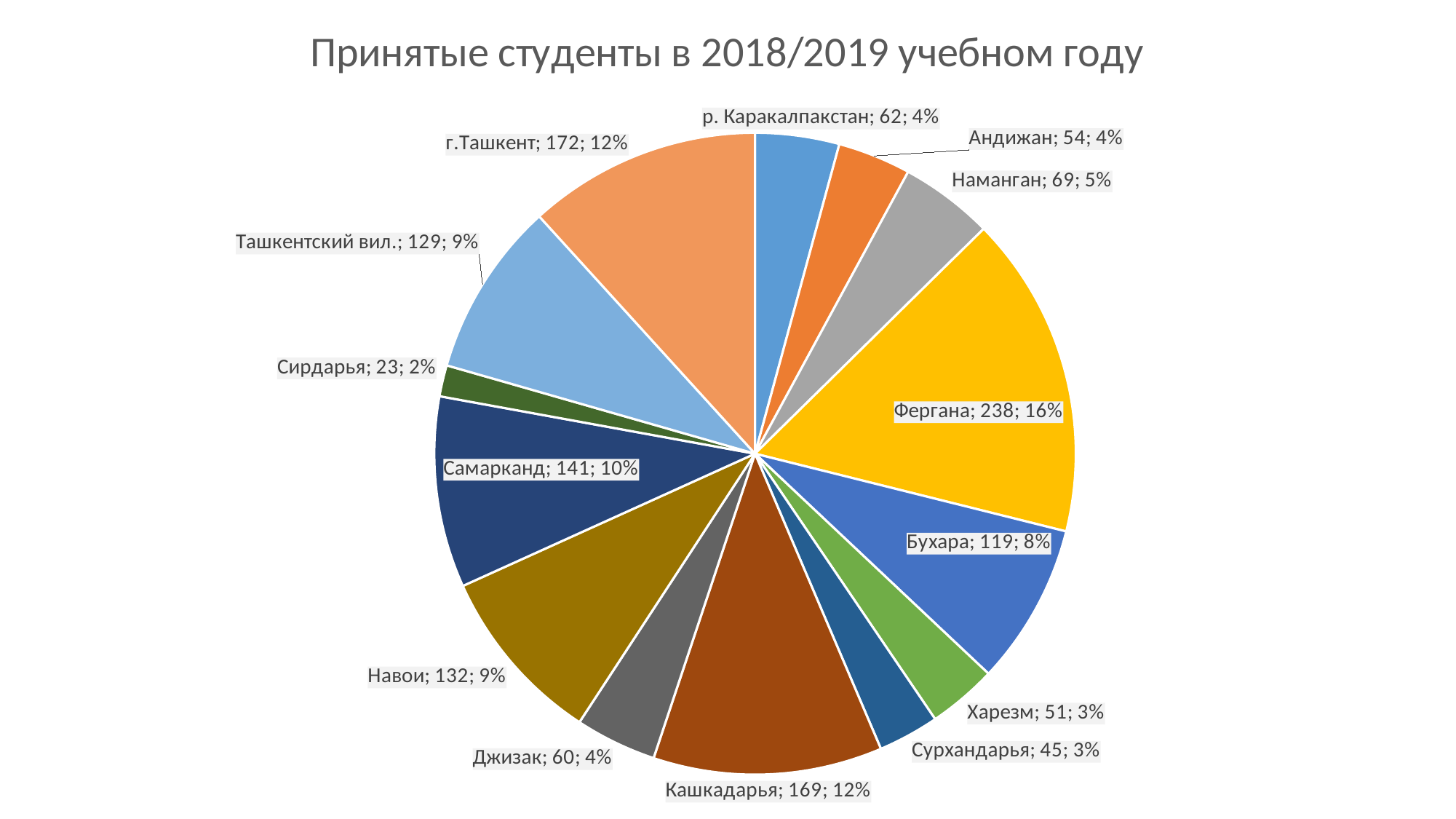
What is the difference between the values for Наманган and Андижан? 15 How many slices does the pie chart have? 14 What is the difference between the values for г.Ташкент and Кашкадарья? 3 Which region has the smallest slice? Сирдарья What share of the pie does Кашкадарья represent? 12% How many students were admitted from Фергана? 238 Which is larger, the value for Навои or the value for Ташкентский вил.? Навои What share of the pie does Сирдарья represent? 2% Which region has the largest slice? Фергана What is the value shown for Самарканд? 141 What is the title of the chart? Принятые студенты в 2018/2019 учебном году What kind of chart is shown on the slide? pie chart